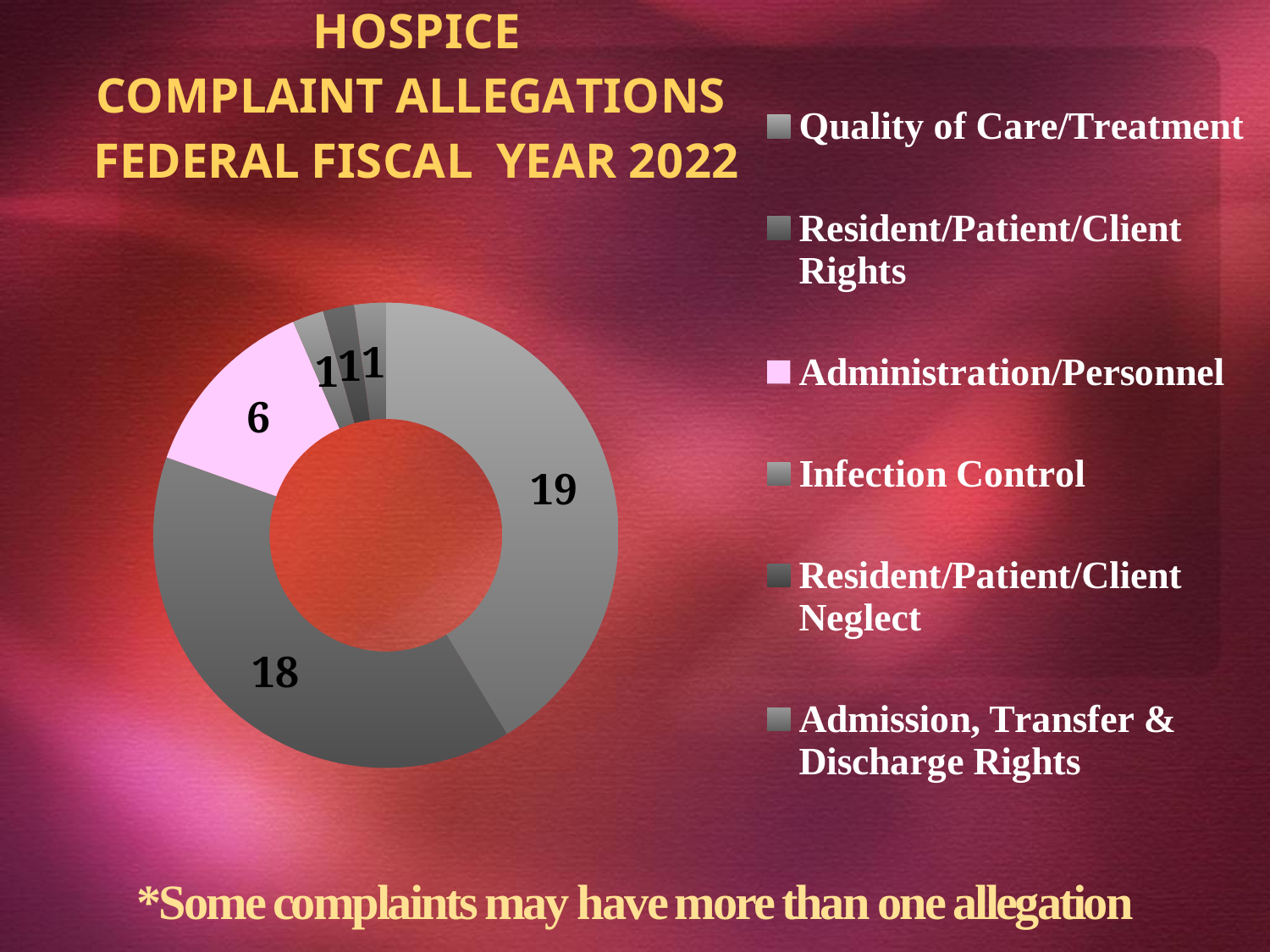
What is the difference between the values for Resident/Patient/Client Rights and Administration/Personnel? 12 What is the value for Quality of Care/Treatment? 19 What is the difference between the values for Quality of Care/Treatment and Resident/Patient/Client Rights? 1 What is the value for Resident/Patient/Client Rights? 18 Which is larger, the value for Administration/Personnel or the value for Infection Control? Administration/Personnel How many categories does the chart show? 6 What is the total of all the values shown in the chart? 46 Which category has the highest value? Quality of Care/Treatment What kind of chart is shown on the slide? Doughnut (pie) chart What is the value for Infection Control? 1 Which category is shown in pink? Administration/Personnel What is the value for Administration/Personnel? 6